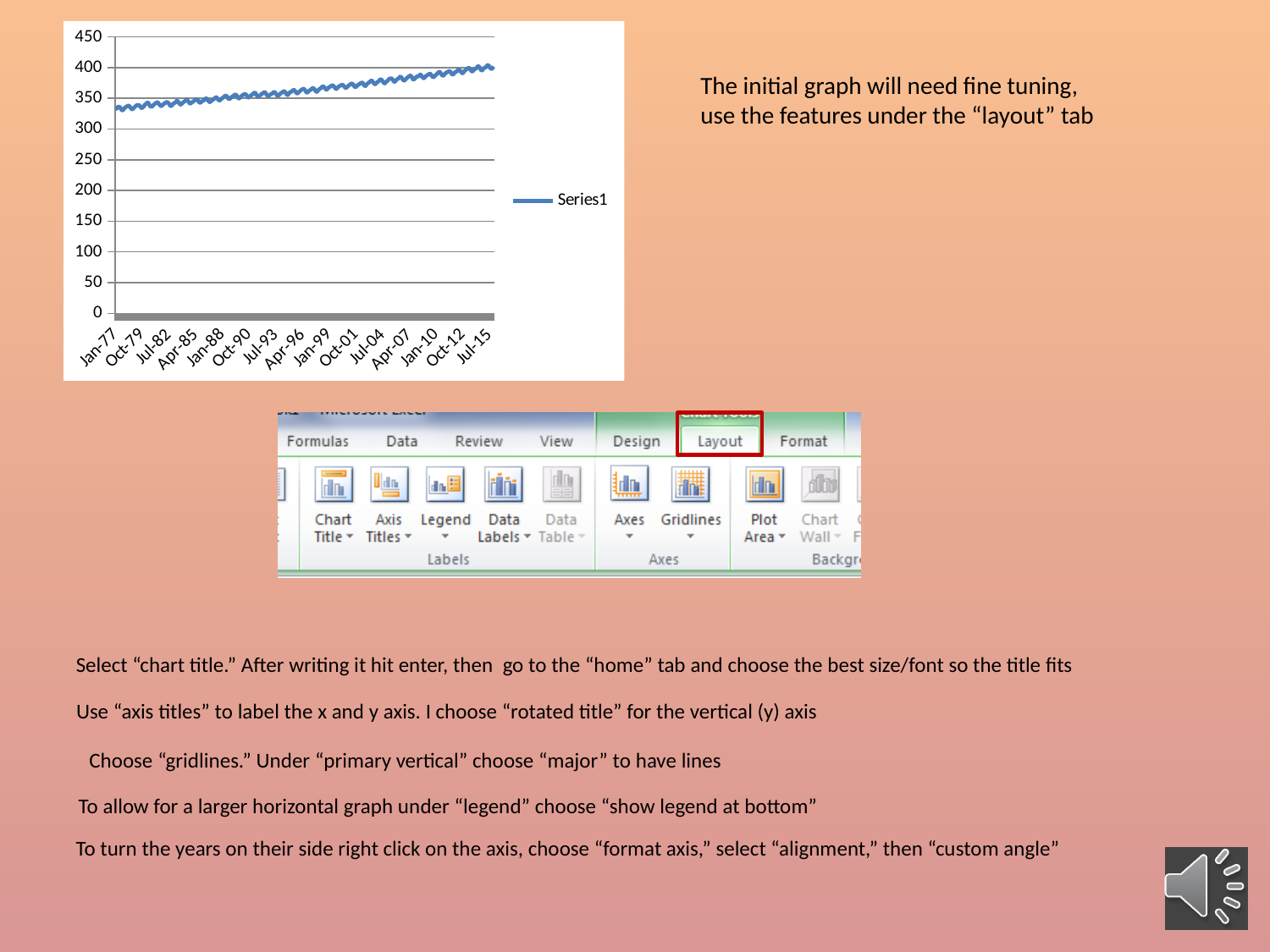
What kind of chart is shown on the slide? line chart What is the name of the series shown in the chart's legend? Series1 Is the value for Series1 at Jan-77 greater or less than 350? less How many series does the chart's legend list? 1 Is the value for Series1 at Jan-77 greater or less than 300? greater What is the highest value shown on the chart's vertical axis? 450 How many date labels are shown along the chart's x axis? 15 Is the value for Series1 at Jul-15 greater or less than 450? less What is the first date label on the chart's x axis? Jan-77 Do the values of Series1 rise or fall from Jan-77 to Jul-15? rise Which is larger, the value of Series1 at Jan-77 or at Jul-15? Jul-15